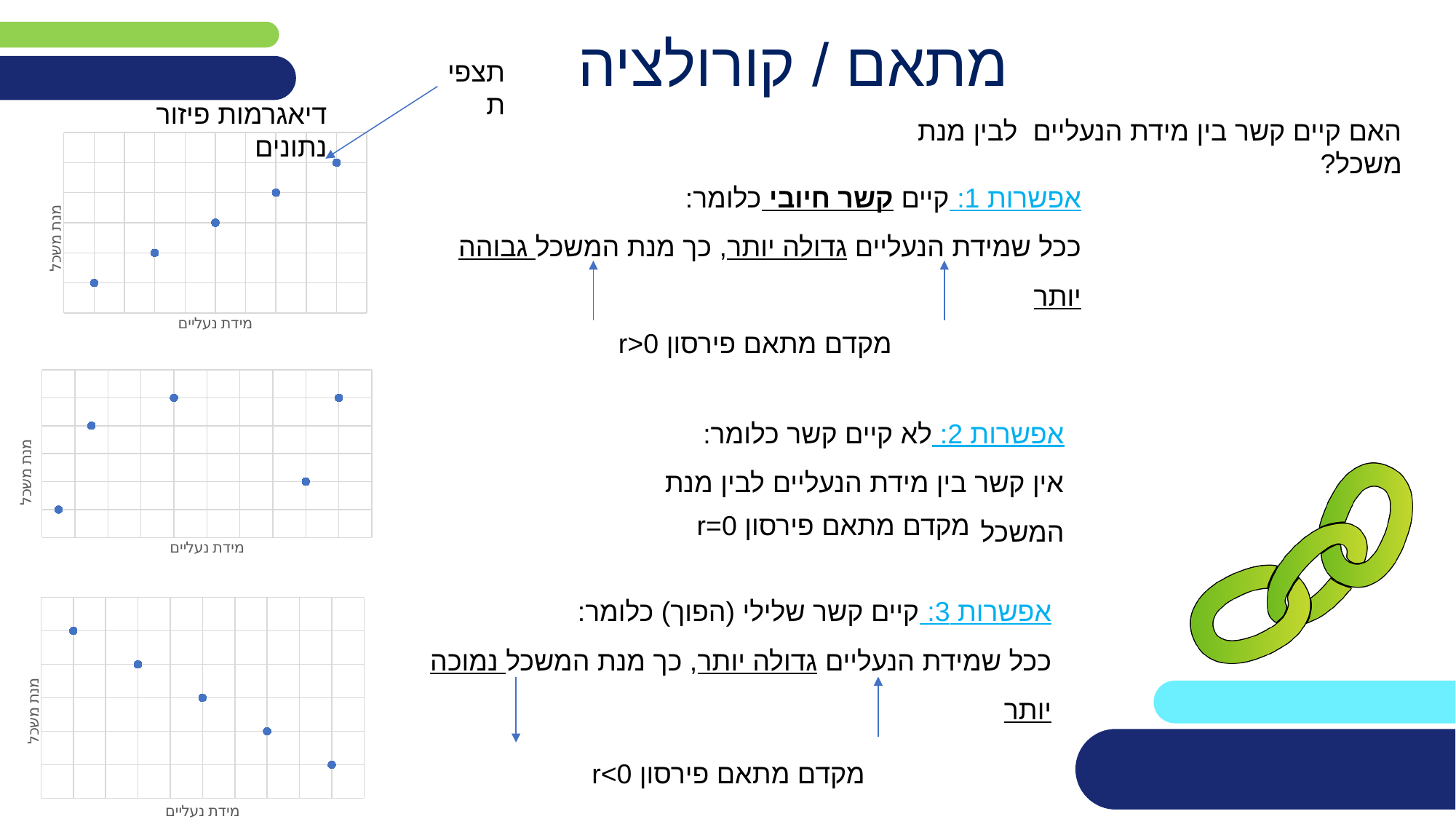
What is the y-axis label of the bottom chart on the left? מנת משכל How many points are plotted in the top chart on the left? 5 What is the x-axis label of the top chart on the left? מידת נעליים How many points are plotted in the bottom chart on the left? 5 How many scatter plots are shown on the slide? 3 What kind of chart is the bottom chart on the left of the slide? Scatter plot In the top chart on the left, do the values rise or fall as you move along the x axis? Rise In the middle chart on the left, do the points show a clear rising or falling trend along the x axis? No clear trend In the bottom chart on the left, do the values rise or fall as you move along the x axis? Fall What kind of chart is the top chart on the left of the slide? Scatter plot